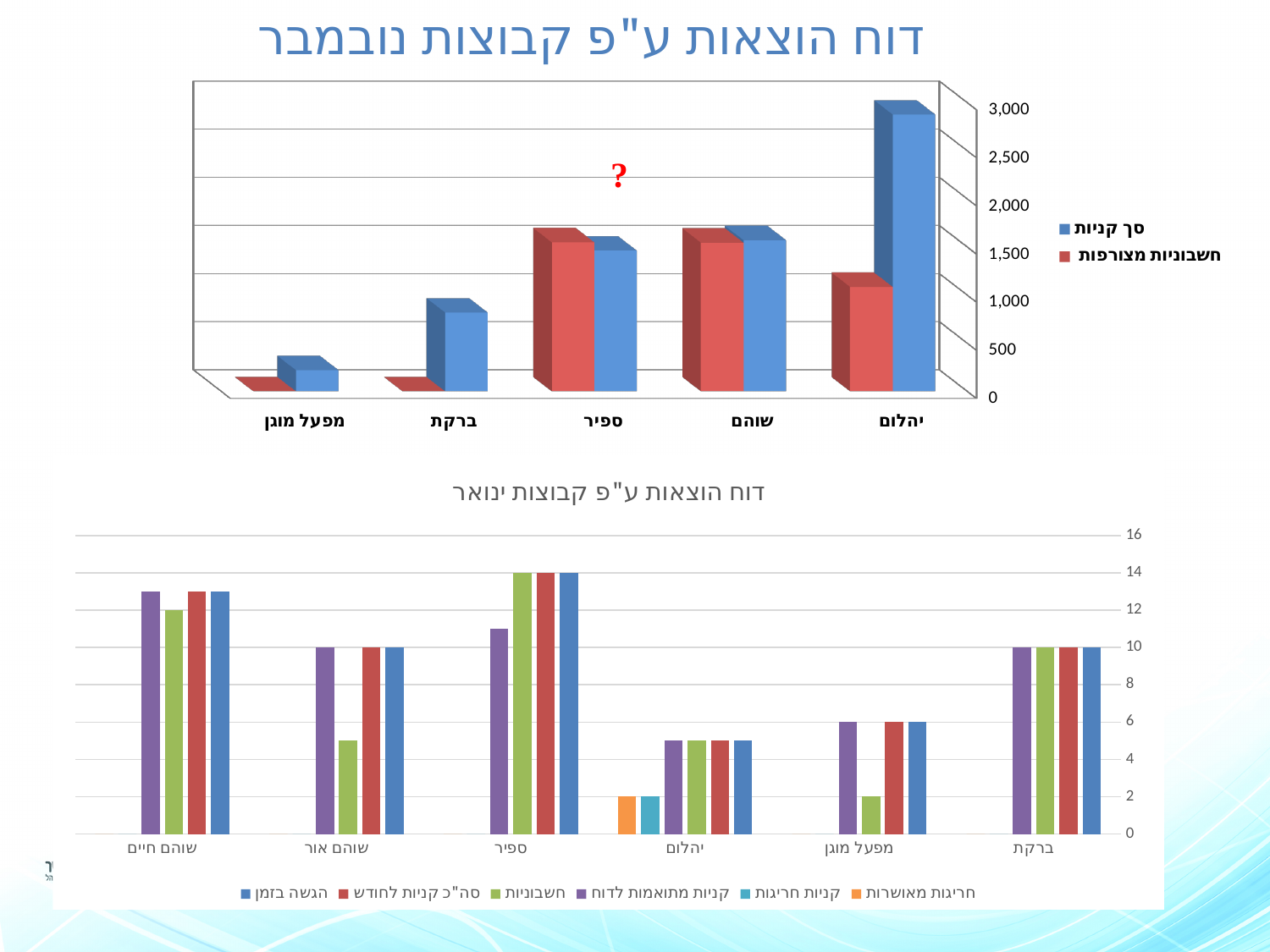
How many categories are shown on the x axis of the bottom chart (דוח הוצאות ע"פ קבוצות ינואר)? 6 In the top chart (דוח הוצאות ע"פ קבוצות נובמבר), which category has the highest value for סך קניות? יהלום How many series does the legend of the top chart (דוח הוצאות ע"פ קבוצות נובמבר) list? 2 What kind of chart is the bottom chart (דוח הוצאות ע"פ קבוצות ינואר)? bar chart In the bottom chart (דוח הוצאות ע"פ קבוצות ינואר), what is the value of הגשה בזמן for ברקת? 10 In the top chart (דוח הוצאות ע"פ קבוצות נובמבר), which category has the lowest value for סך קניות? מפעל מוגן In the top chart (דוח הוצאות ע"פ קבוצות נובמבר), is the סך קניות value for יהלום greater or less than 2,500? greater In the top chart (דוח הוצאות ע"פ קבוצות נובמבר), for יהלום, which is larger: סך קניות or חשבוניות מצורפות? סך קניות In the bottom chart (דוח הוצאות ע"פ קבוצות ינואר), what is the value of חשבוניות for ספיר? 14 In the bottom chart (דוח הוצאות ע"פ קבוצות ינואר), which category has the highest value for הגשה בזמן? ספיר In the bottom chart (דוח הוצאות ע"פ קבוצות ינואר), what is the value of קניות חריגות for יהלום? 2 In the top chart (דוח הוצאות ע"פ קבוצות נובמבר), is the סך קניות value for ברקת greater or less than 1,000? less